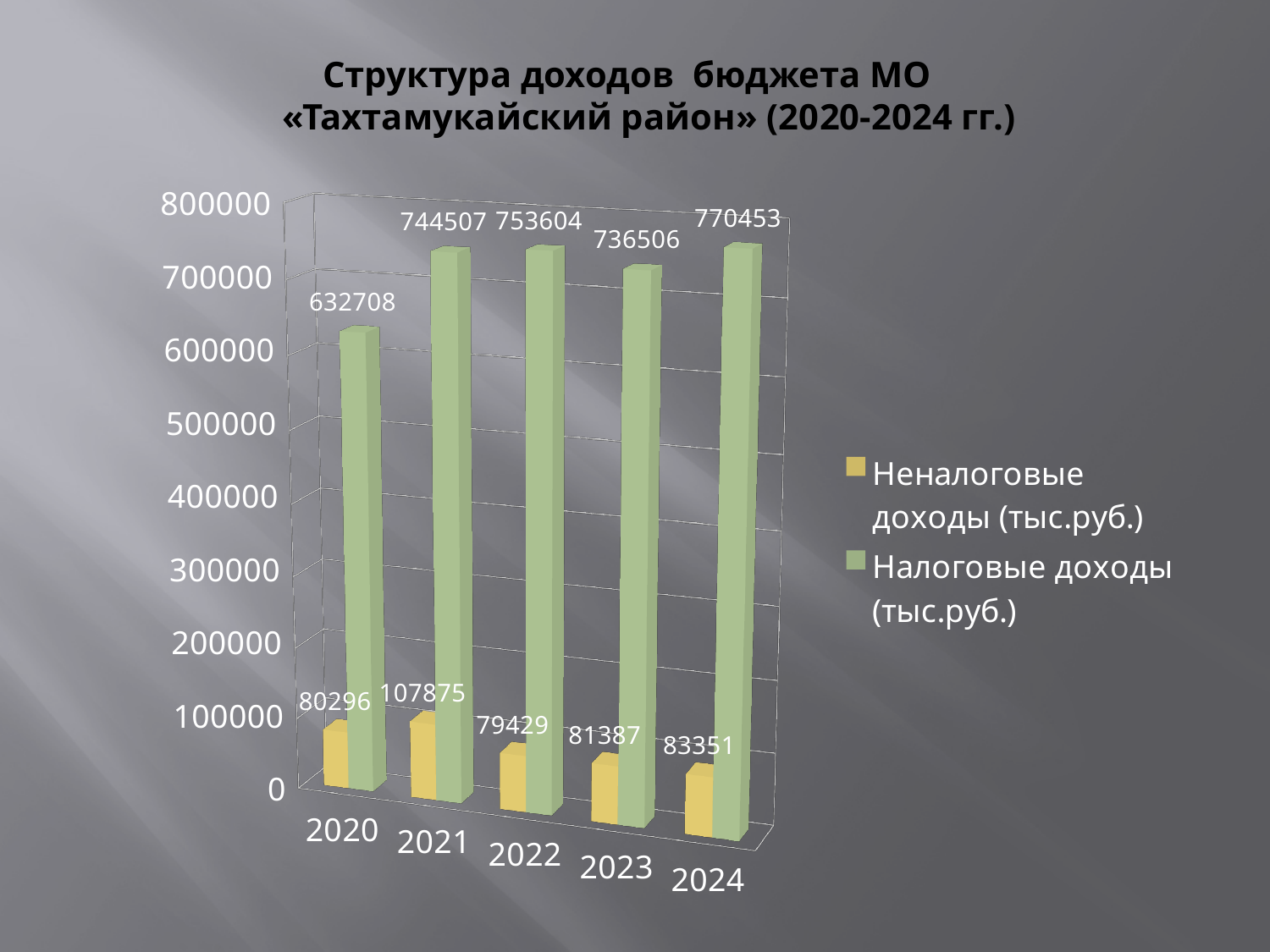
What is the value of Неналоговые доходы (тыс.руб.) for 2021? 107875 How many years are shown on the x axis? 5 What is the value of Налоговые доходы (тыс.руб.) for 2020? 632708 Is the value of Неналоговые доходы (тыс.руб.) for 2021 greater or less than 100000? greater What is the combined value of Налоговые доходы and Неналоговые доходы for 2024? 853804 How many series does the legend list? 2 In which year is Неналоговые доходы (тыс.руб.) lowest? 2022 In which year is Налоговые доходы (тыс.руб.) highest? 2024 Which is larger: Налоговые доходы (тыс.руб.) in 2022 or in 2023? 2022 What is the difference between Налоговые доходы (тыс.руб.) in 2024 and in 2020? 137745 What kind of chart is shown on the slide? bar chart What is the value of Налоговые доходы (тыс.руб.) for 2023? 736506